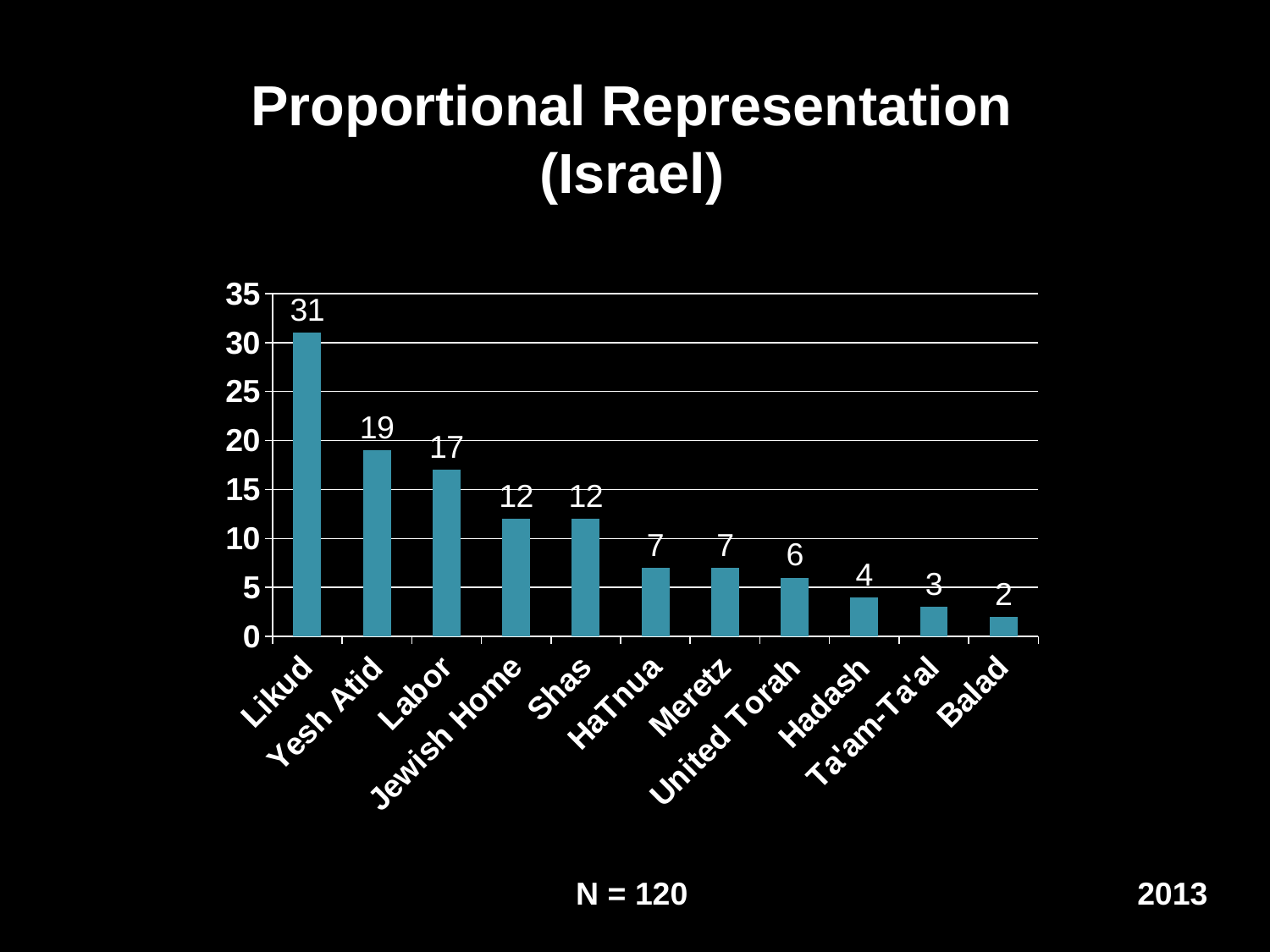
What is the value for United Torah? 6 What is the value for Likud? 31 Which is larger, the value for Labor or the value for Jewish Home? Labor What kind of chart is this? Bar chart Do the values rise or fall from left to right along the x axis? Fall What is the value for Ta'am-Ta'al? 3 What is the difference between the values for Labor and Shas? 5 What is the value for Yesh Atid? 19 What is the difference between the values for Likud and Yesh Atid? 12 How many categories are shown on the x axis? 11 Which category has the lowest value? Balad Which category has the highest value? Likud